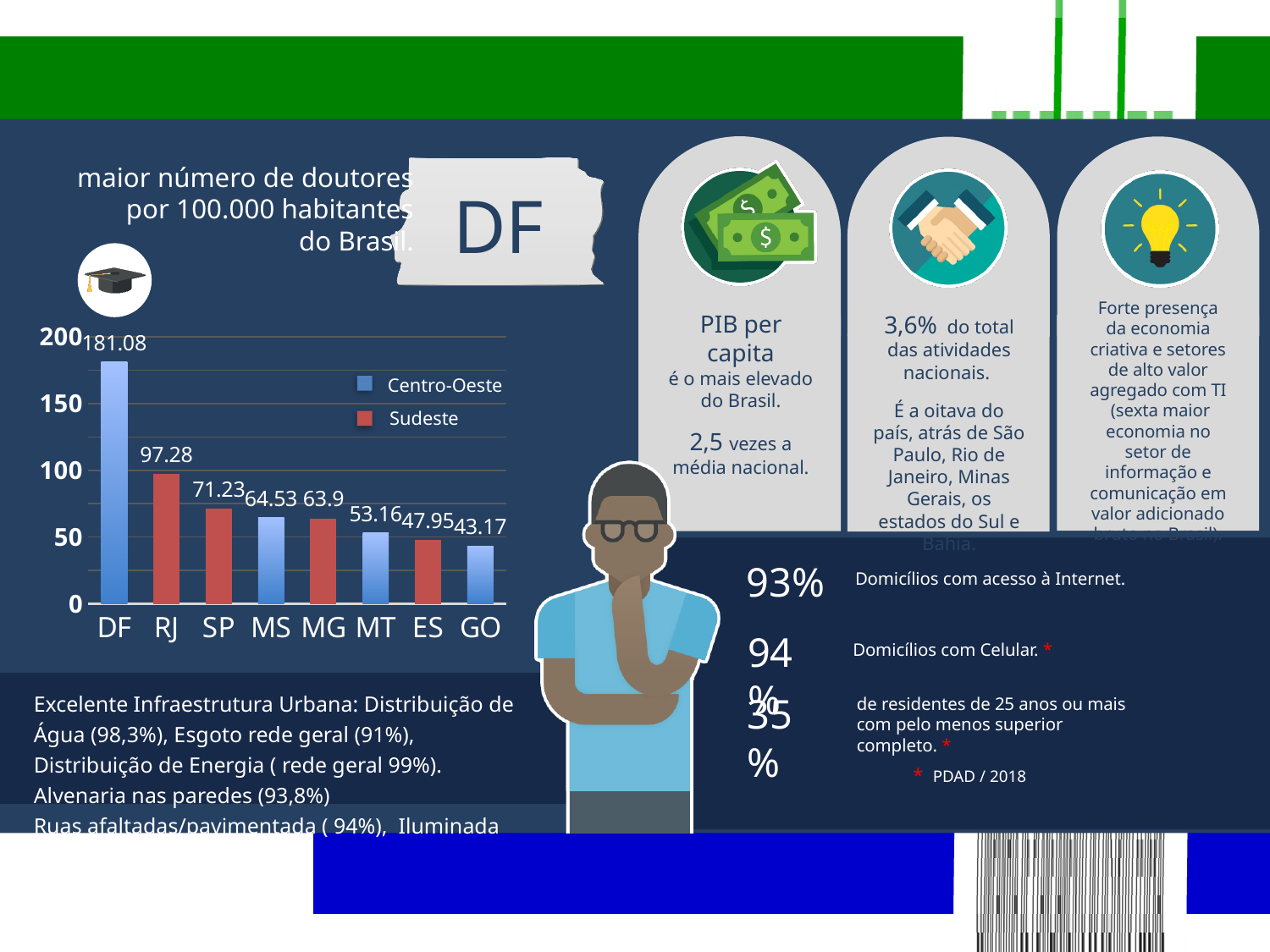
What kind of chart is shown on the slide? bar chart Which legend entry is shown in red in the bar chart? Sudeste What is the value for DF in the bar chart? 181.08 What is the value for RJ in the bar chart? 97.28 Which category has the lowest value in the bar chart? GO Is the value for ES in the bar chart greater or less than 50? less What is the value for MT in the bar chart? 53.16 How many categories are shown on the x axis of the bar chart? 8 How many series does the legend of the bar chart list? 2 What is the difference between the values for DF and RJ in the bar chart? 83.8 Which category has the highest value in the bar chart? DF Which has a larger value in the bar chart, SP or MS? SP